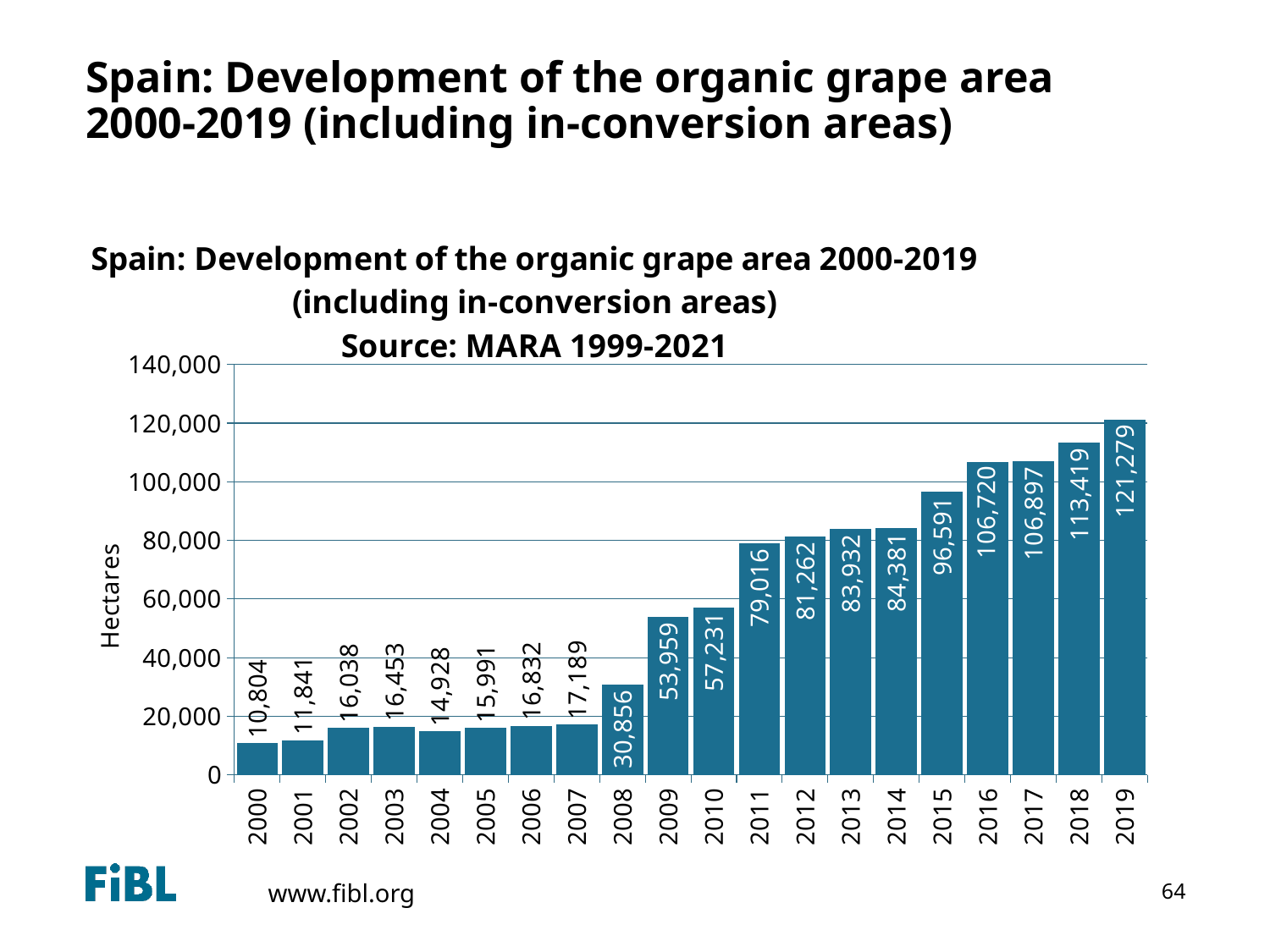
What value is shown for 2015? 96,591 Which year has the highest organic grape area? 2019 Which is larger, the value for 2010 or the value for 2012? 2012 What was the organic grape area in 2000? 10,804 Is the value for 2015 greater or less than 80,000? greater How many years are shown on the x axis? 20 Do the values generally rise or fall from 2000 to 2019? rise Which year has the lowest organic grape area? 2000 What is the difference between the 2019 value and the 2000 value? 110,475 What kind of chart is shown on the slide? bar chart By how much did the area increase from 2008 to 2009? 23,103 What was the organic grape area in Spain in 2008? 30,856